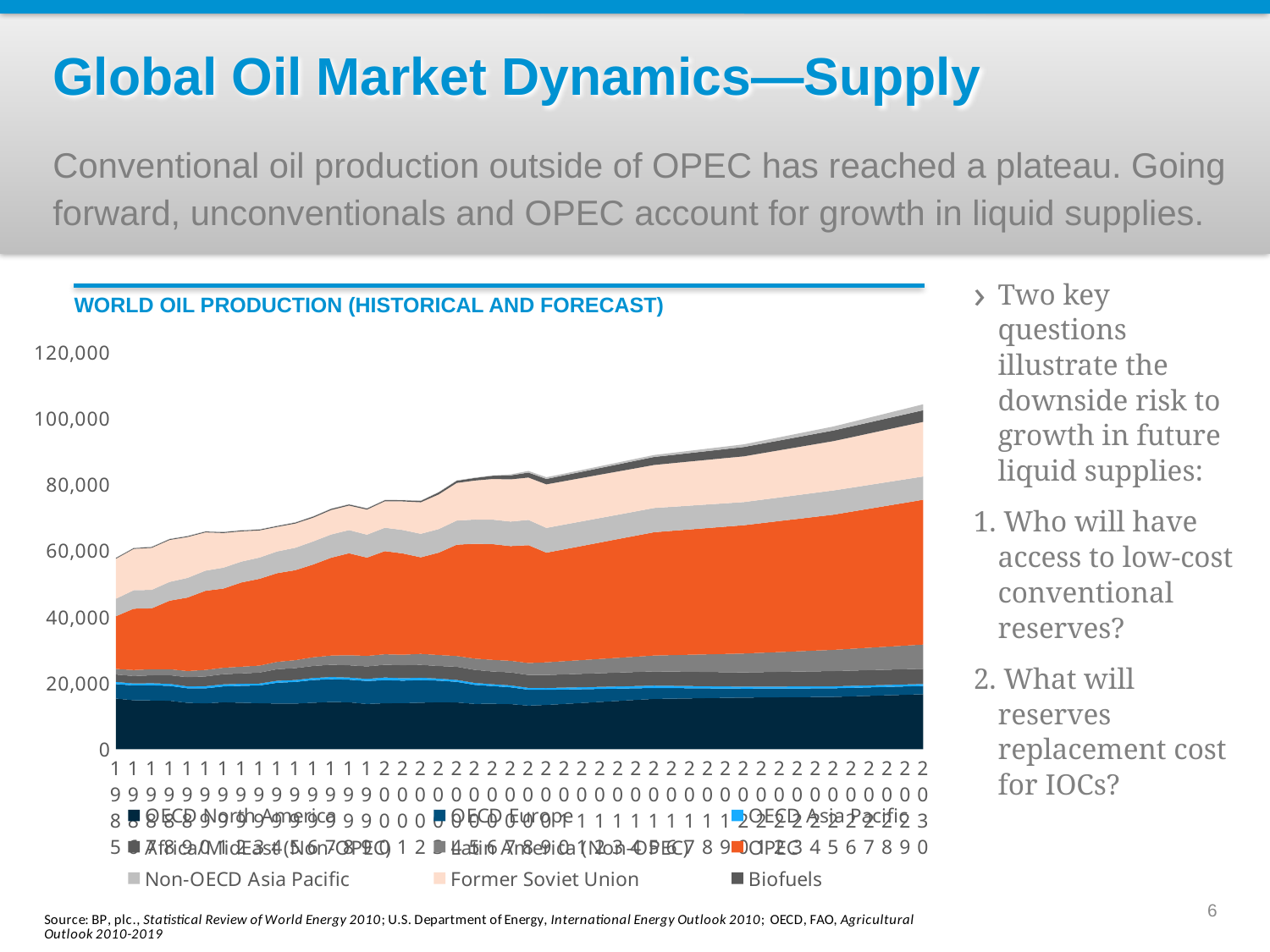
Which series is larger in the chart, OPEC or Biofuels? OPEC Which series occupies the largest area of the chart? OPEC What kind of chart is shown on the slide? stacked area chart Does total world oil production rise or fall from left to right along the x axis? rise What is the highest value shown on the chart's vertical axis? 120,000 Is the total world oil production at the right end of the chart greater or less than 120,000? less Is the total world oil production at the right end of the chart greater or less than 80,000? greater What is the title of the chart on the slide? WORLD OIL PRODUCTION (HISTORICAL AND FORECAST) Which series is larger in the chart, Former Soviet Union or Biofuels? Former Soviet Union How many series does the chart's legend list? 9 Is the total world oil production at the left end of the chart greater or less than 80,000? less